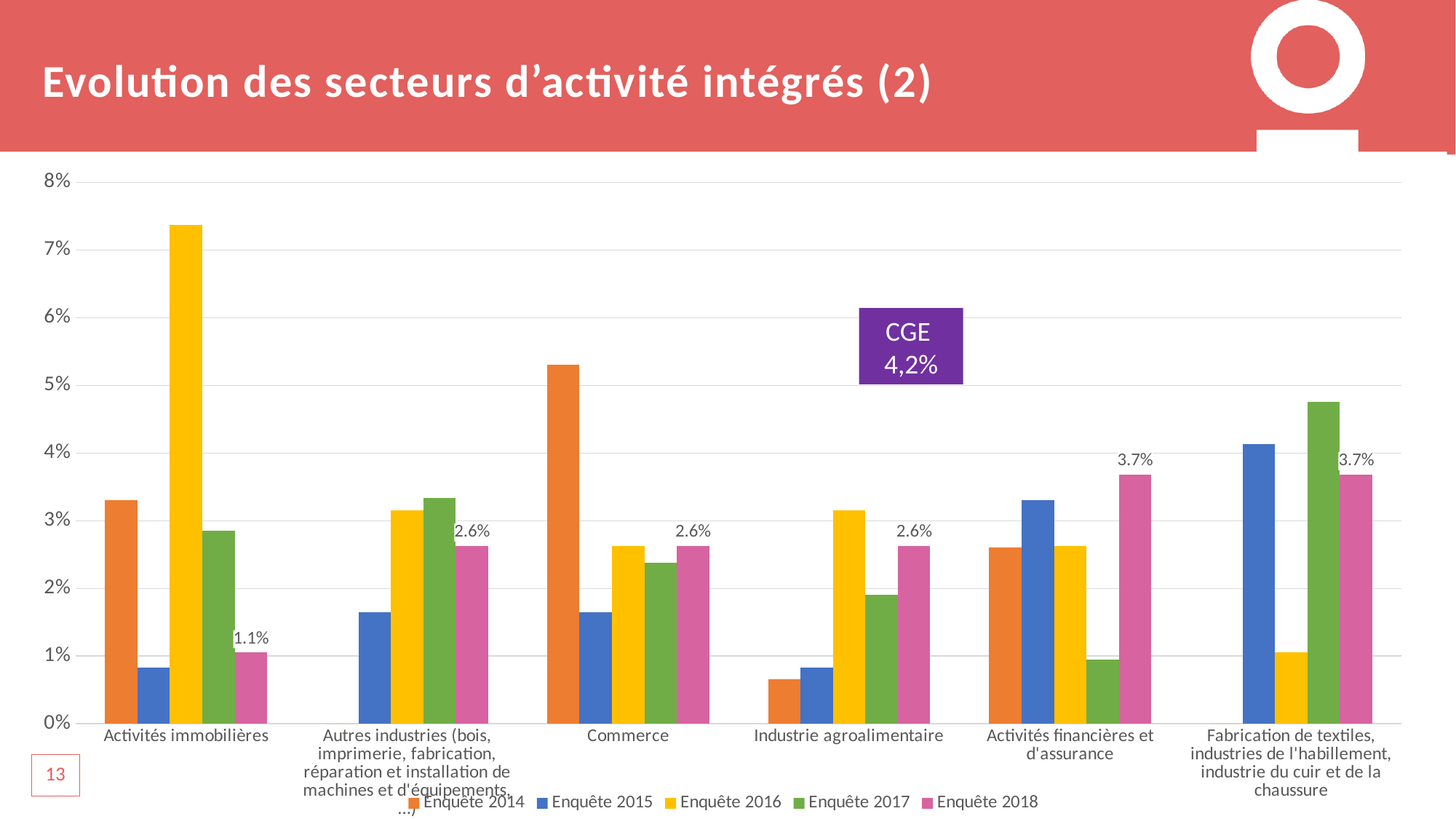
How many sector categories are shown on the x axis? 6 What is the difference between the Enquête 2018 values for Activités financières et d'assurance and Activités immobilières? 2.6% How many series does the legend list? 5 Which category has the lowest Enquête 2018 value? Activités immobilières What is the Enquête 2018 value for Activités immobilières? 1.1% Is the Enquête 2016 value for Activités immobilières greater or less than 7%? greater What is the Enquête 2018 value for Activités financières et d'assurance? 3.7% Is the Enquête 2014 value for Commerce greater or less than 5%? greater What value is shown in the purple CGE box on the chart? 4,2% What kind of chart is shown on the slide? bar chart What is the Enquête 2018 value for Commerce? 2.6% Which category has the highest Enquête 2016 value? Activités immobilières